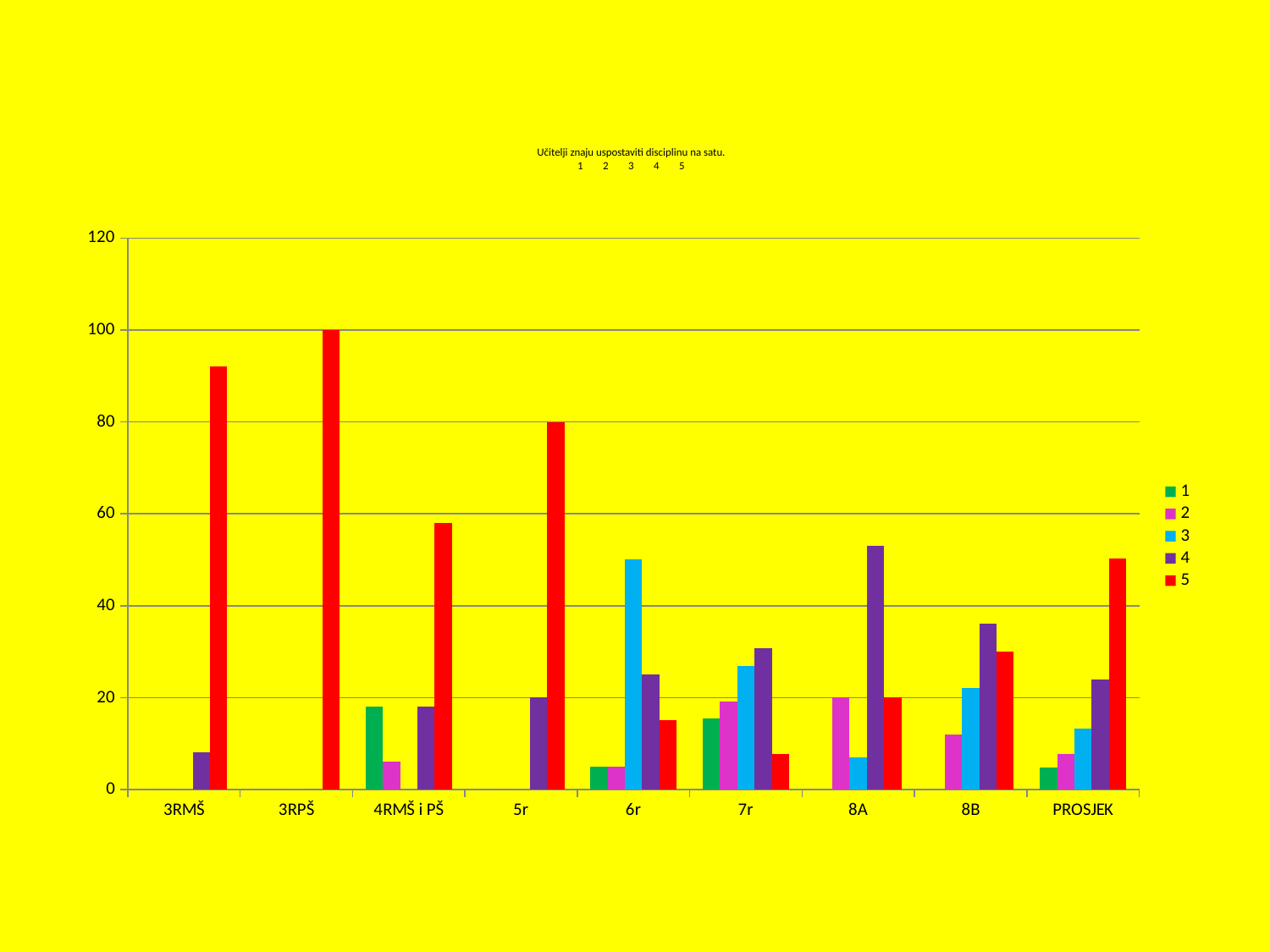
What is the title of the chart? Učitelji znaju uspostaviti disciplinu na satu. Is the value of series 4 for 8A greater or less than 40? greater Is the value of series 5 for 3RMŠ greater or less than 80? greater What is the value of series 4 for 5r? 20 Which category has the highest value for series 5? 3RPŠ What kind of chart is shown on the slide? bar chart What is the value of series 5 for 3RPŠ? 100 How many series does the legend list? 5 How many categories are shown on the x axis? 9 Is the value of series 4 for 8B greater or less than 40? less Which is larger: series 5 for 3RMŠ or series 5 for 5r? 3RMŠ What is the value of series 5 for 5r? 80